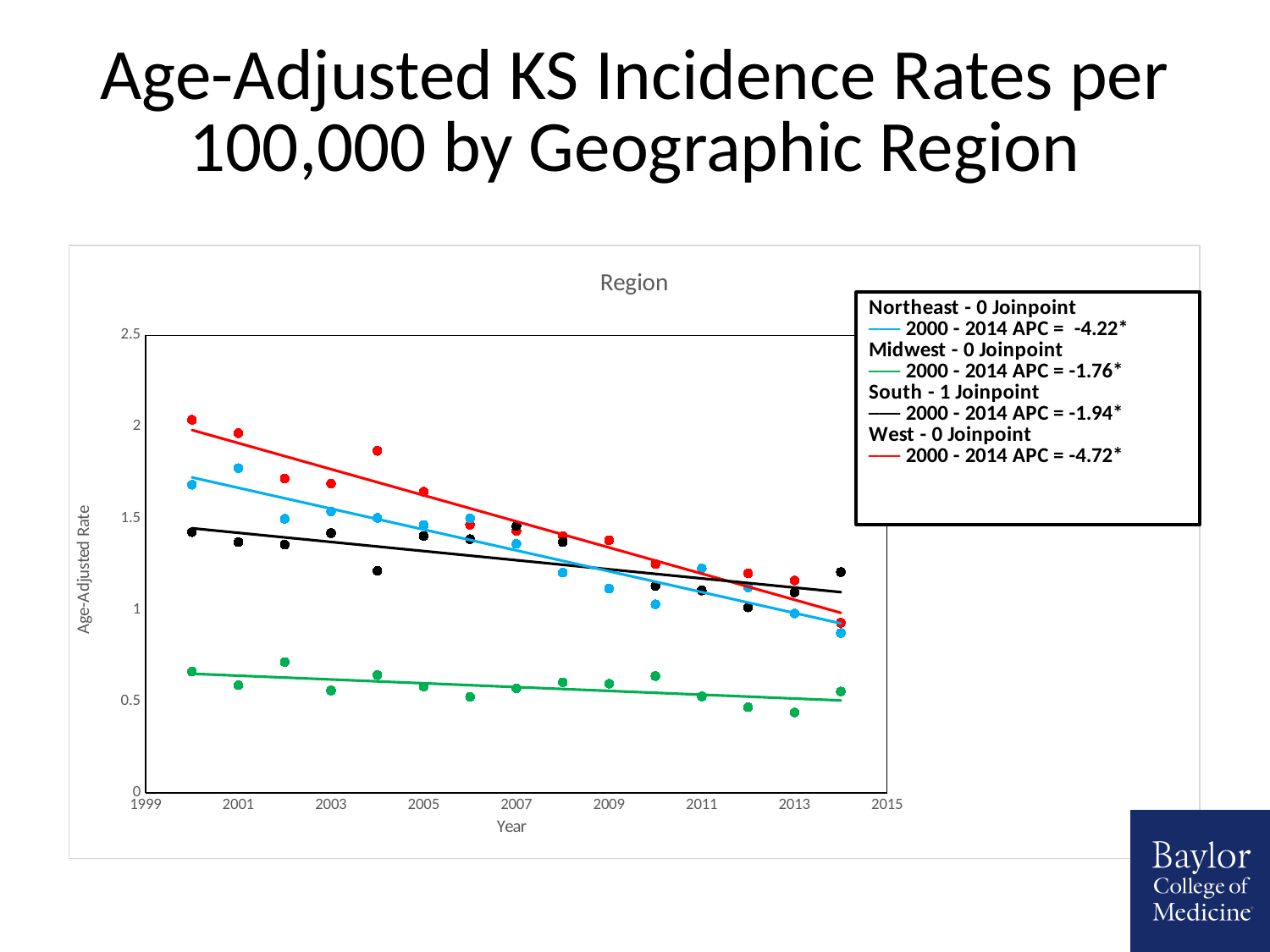
Which region has the lowest age-adjusted rate across the years shown? Midwest Which region has the highest age-adjusted rate in 2000? West In 2014, which region has the higher value, South or Northeast? South What is the 2000 - 2014 APC for the Midwest region according to the legend? -1.76* How many regions (series) does the legend list? 4 Is the Midwest region's value in 2000 greater or less than 1? less Does the Northeast region's rate rise or fall from 2000 to 2014? Fall Which region is listed in the legend with 1 joinpoint? South What is the 2000 - 2014 APC for the Northeast region according to the legend? -4.22* What is the 2000 - 2014 APC for the West region according to the legend? -4.72* What kind of chart is shown on the slide? Scatter plot with fitted trend lines